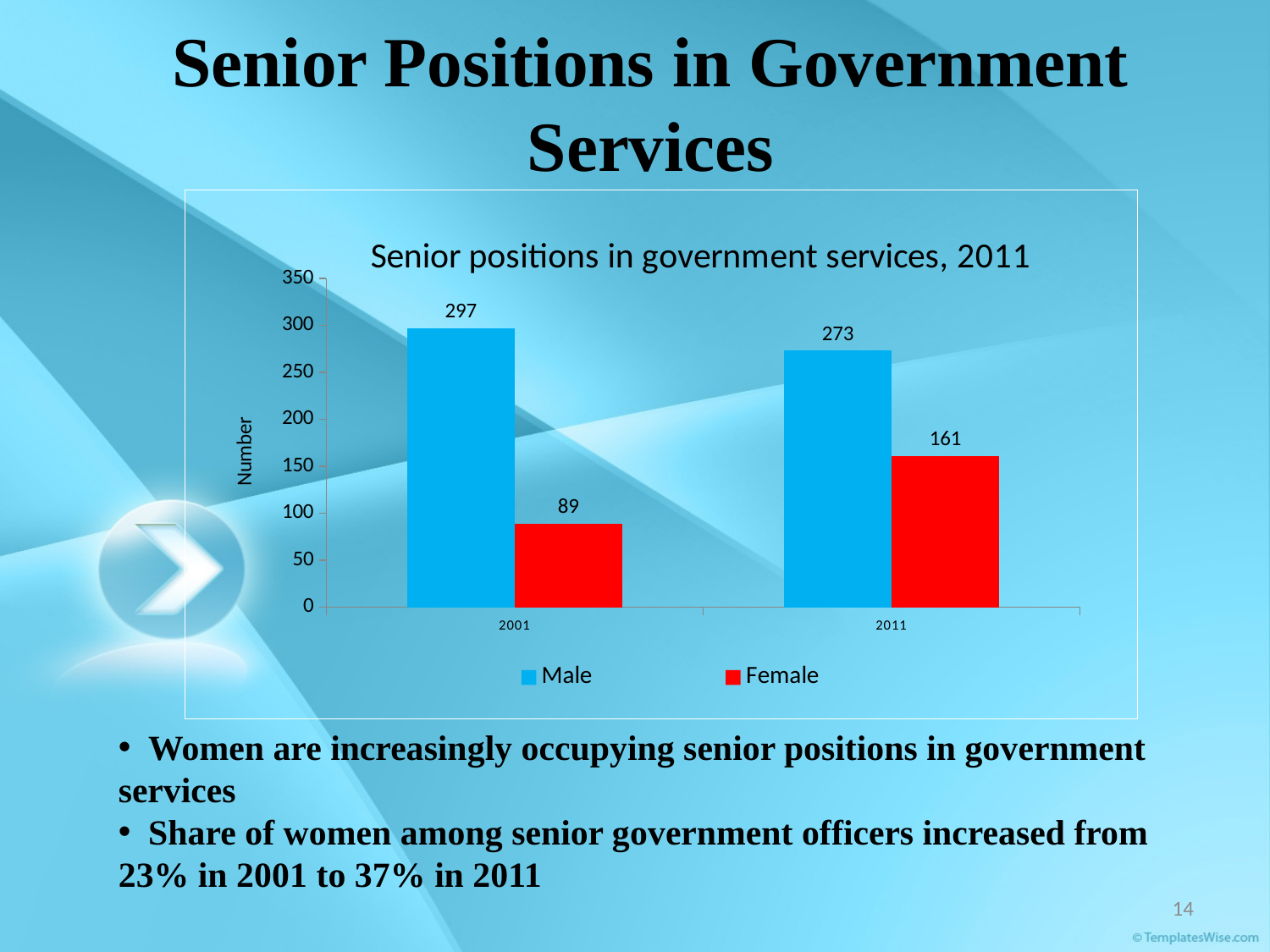
What kind of chart is shown? Bar chart Which is larger: the Female value in 2001 or the Female value in 2011? Female in 2011 What is the value for Female in 2011? 161 How many years are shown on the x axis? 2 How many series does the legend list? 2 What is the difference between the Male and Female values in 2011? 112 What is the value for Male in 2001? 297 What is the title of the chart? Senior positions in government services, 2011 Is the value for Female in 2011 greater or less than 150? greater Which year has the highest Male value? 2001 Which year has the lowest Female value? 2001 What is the value for Female in 2001? 89